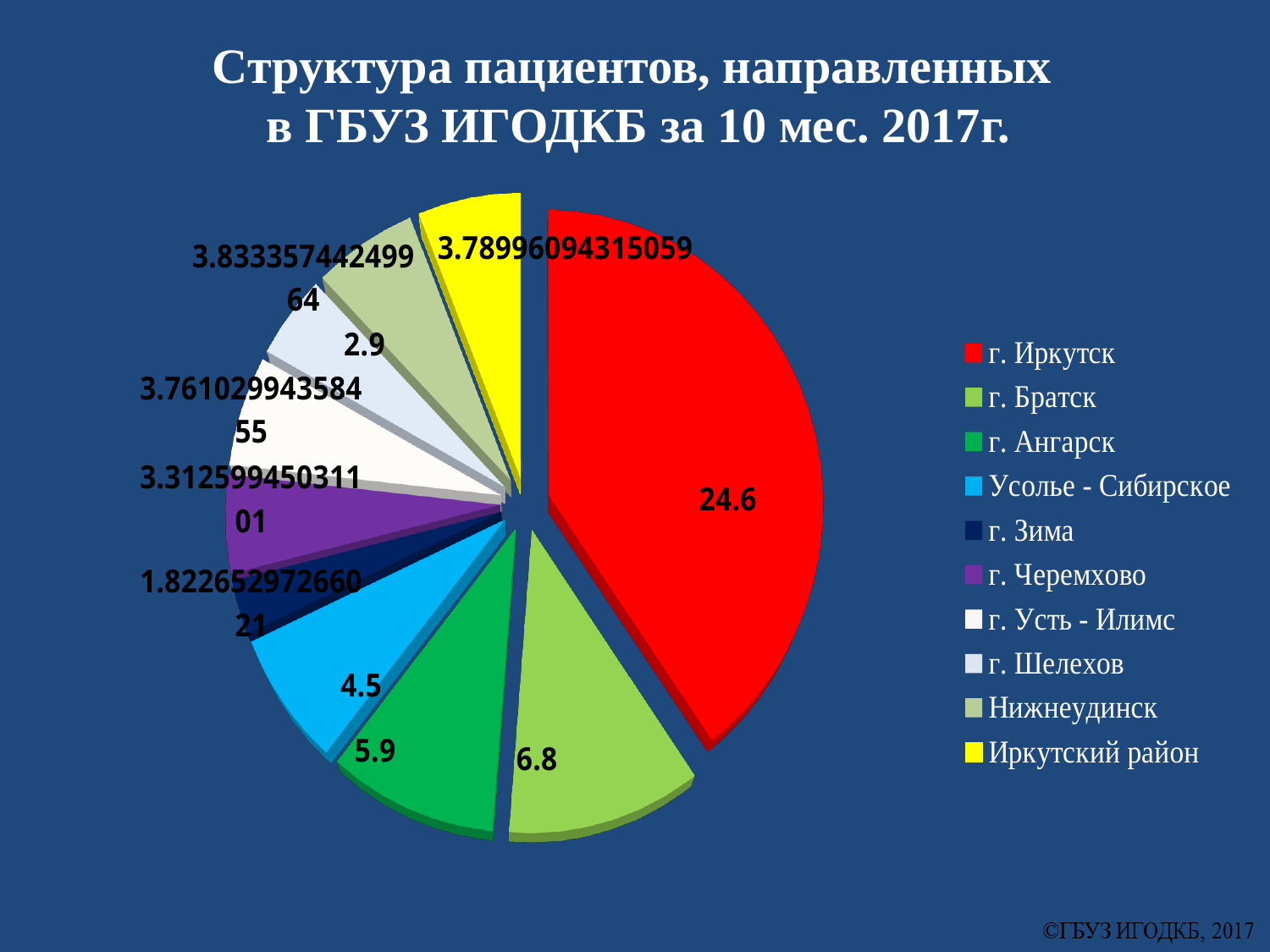
What colour is the slice for Иркутский район? yellow What is the value shown for г. Шелехов? 2.9 What is the value shown for Усолье - Сибирское? 4.5 What type of chart is shown on the slide? pie chart What is the difference between the values for г. Иркутск and г. Братск? 17.8 What is the value shown for г. Иркутск? 24.6 Which is larger, the value for г. Братск or the value for г. Ангарск? г. Братск Which category has the largest slice of the pie? г. Иркутск What is the value shown for г. Ангарск? 5.9 Which category has the smallest slice of the pie? г. Зима How many categories does the pie chart have? 10 What is the value shown for г. Братск? 6.8